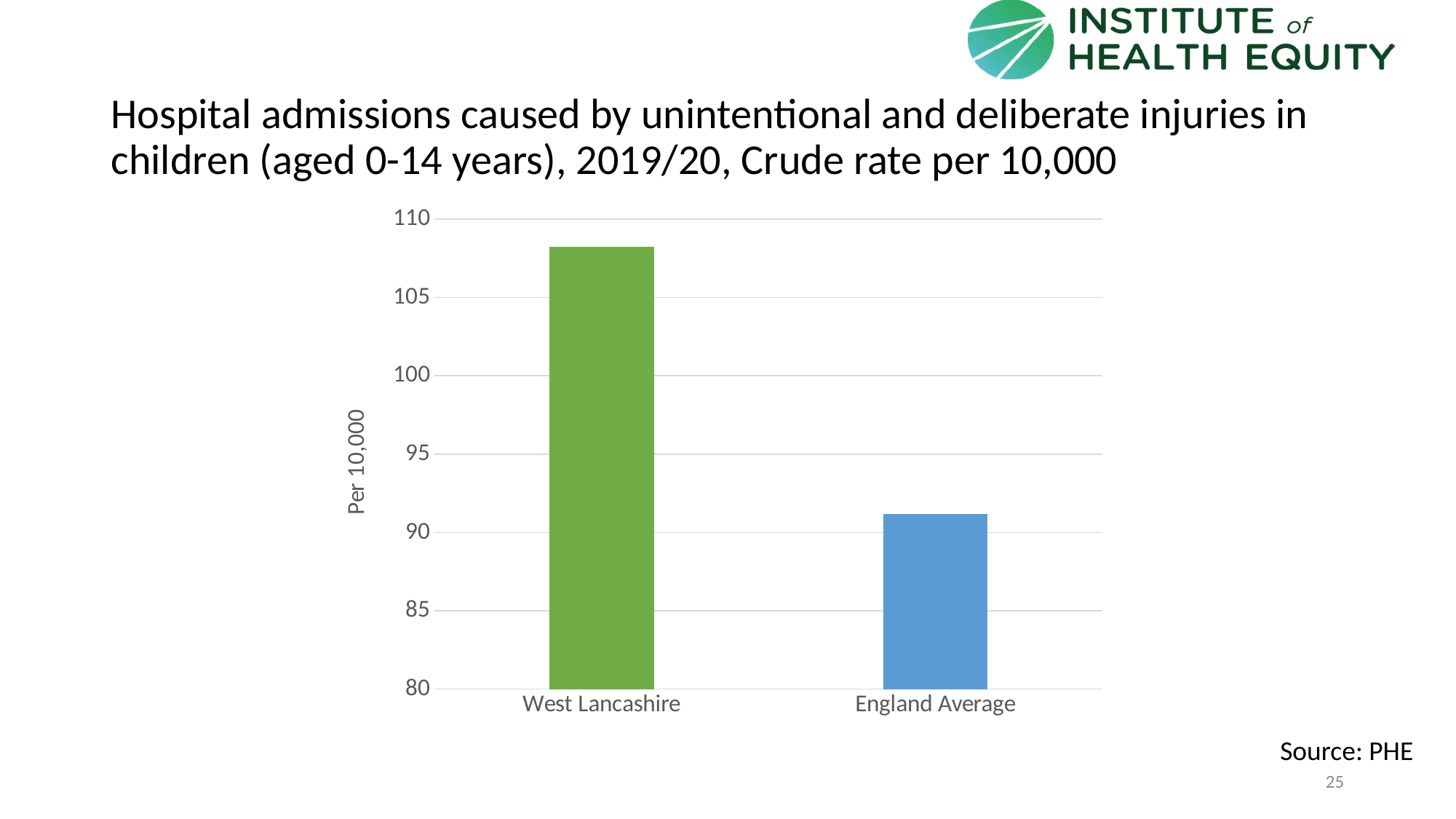
What colour is the bar for West Lancashire? Green What is the label on the vertical axis of the chart? Per 10,000 Which category has the highest value? West Lancashire Is the value for England Average greater or less than 95? less Is the value for West Lancashire greater or less than 110? less Which category has the lowest value? England Average Which is larger, the value for West Lancashire or the value for England Average? West Lancashire Is the value for England Average greater or less than 90? greater How many categories are plotted on the chart? 2 What kind of chart is shown on the slide? Bar chart